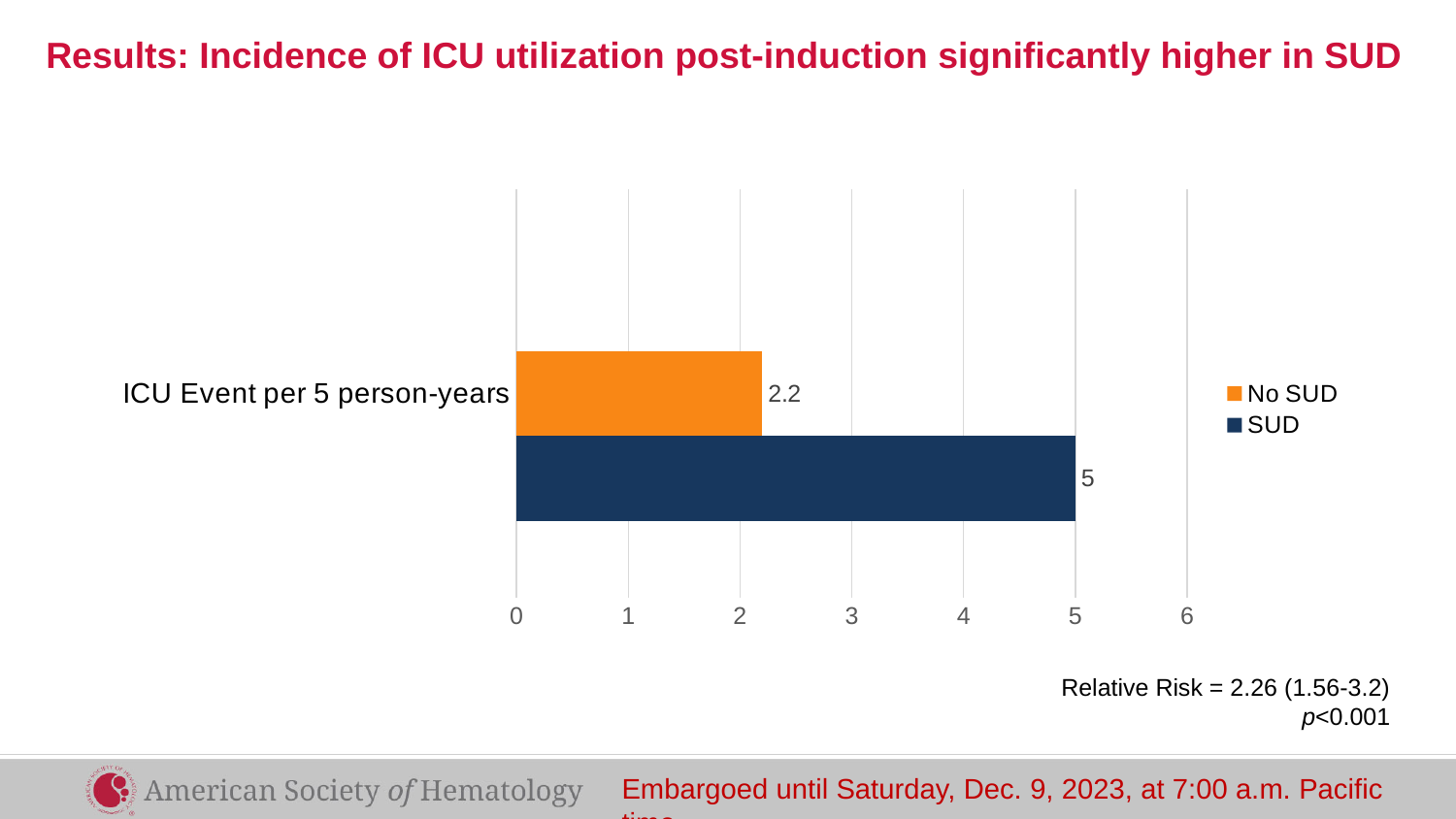
What kind of chart is shown on the slide? Bar chart How many series does the legend list? 2 What is the difference between the SUD and No SUD values for ICU Event per 5 person-years? 2.8 Is the value for SUD greater or less than 4? greater What is the category label on the chart? ICU Event per 5 person-years Which series is shown in orange? No SUD How many categories are shown on the chart? 1 What is the value for SUD for ICU Event per 5 person-years? 5 What is the highest value shown on the x axis? 6 What is the value for No SUD for ICU Event per 5 person-years? 2.2 Which series has the higher value for ICU Event per 5 person-years, SUD or No SUD? SUD Is the value for No SUD greater or less than 3? less